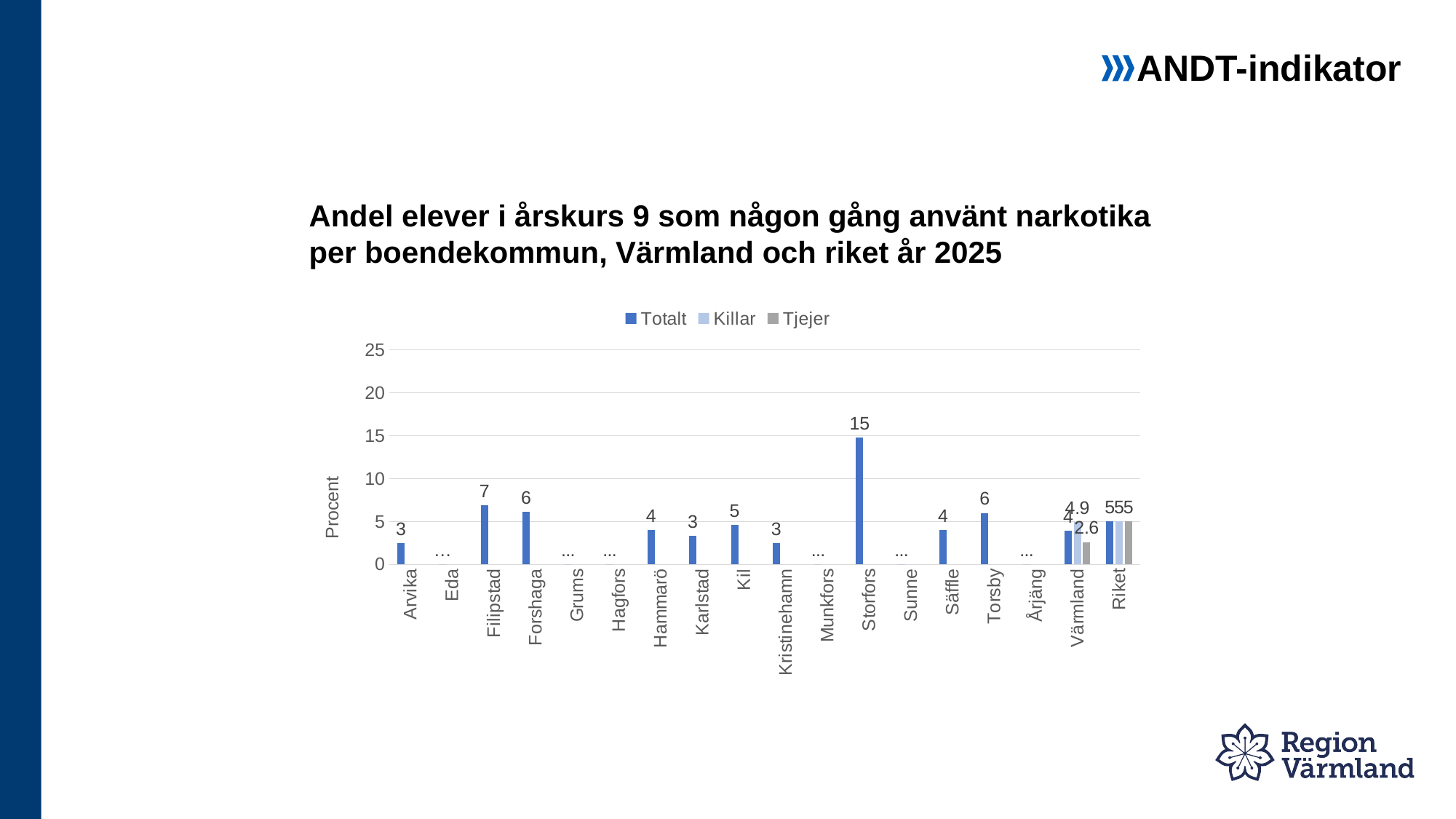
What is the difference between the Killar and Tjejer values for Värmland? 2.3 What is the label on the y axis? Procent What is the Totalt value for Filipstad? 7 What is the Totalt value for Storfors? 15 How many series does the legend list? 3 What is the difference between the Totalt values for Filipstad and Arvika? 4 What is the Killar value for Värmland? 4.9 Which municipality has the highest Totalt value? Storfors Which has a larger Totalt value, Forshaga or Hammarö? Forshaga How many categories are shown on the x axis? 18 What is the Tjejer value for Värmland? 2.6 What kind of chart is shown on the slide? bar chart